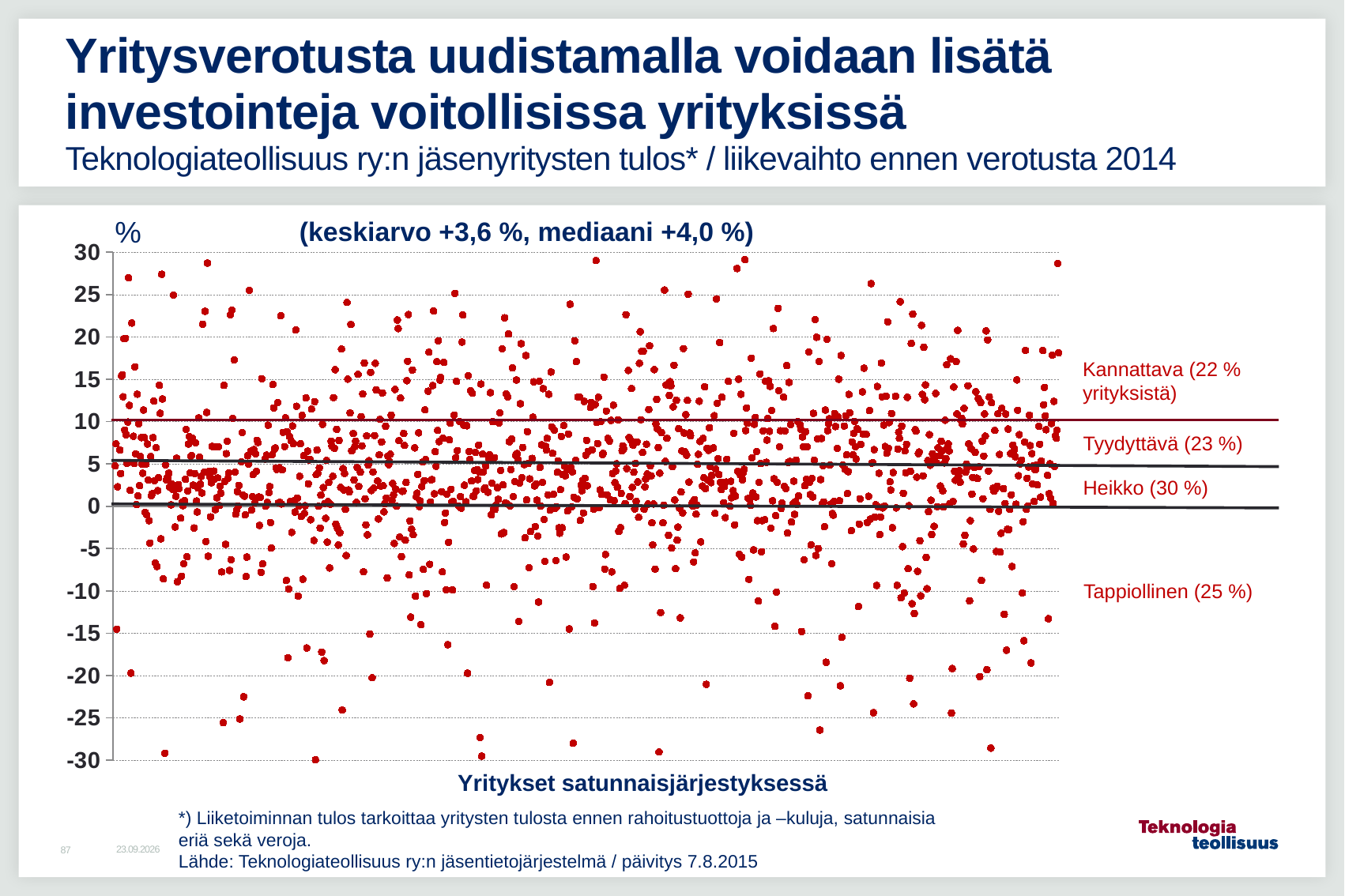
Which profitability class has the smallest share of companies? Kannattava (22 %) What share of companies is labelled Heikko? 30 % What share of companies is labelled Tyydyttävä? 23 % Which profitability class has the largest share of companies? Heikko (30 %) What is the difference in percentage points between the Heikko share and the Kannattava share? 8 percentage points How many profitability classes are labelled on the right side of the chart? 4 What is the median (mediaani) value stated in the chart heading? +4,0 % Which is larger, the average (keskiarvo) or the median (mediaani) shown in the chart heading? Median (+4,0 %) What is the average (keskiarvo) value stated in the chart heading? +3,6 % What share of companies is labelled Tappiollinen? 25 % What kind of chart is shown on the slide? Scatter plot What share of companies is labelled Kannattava? 22 %